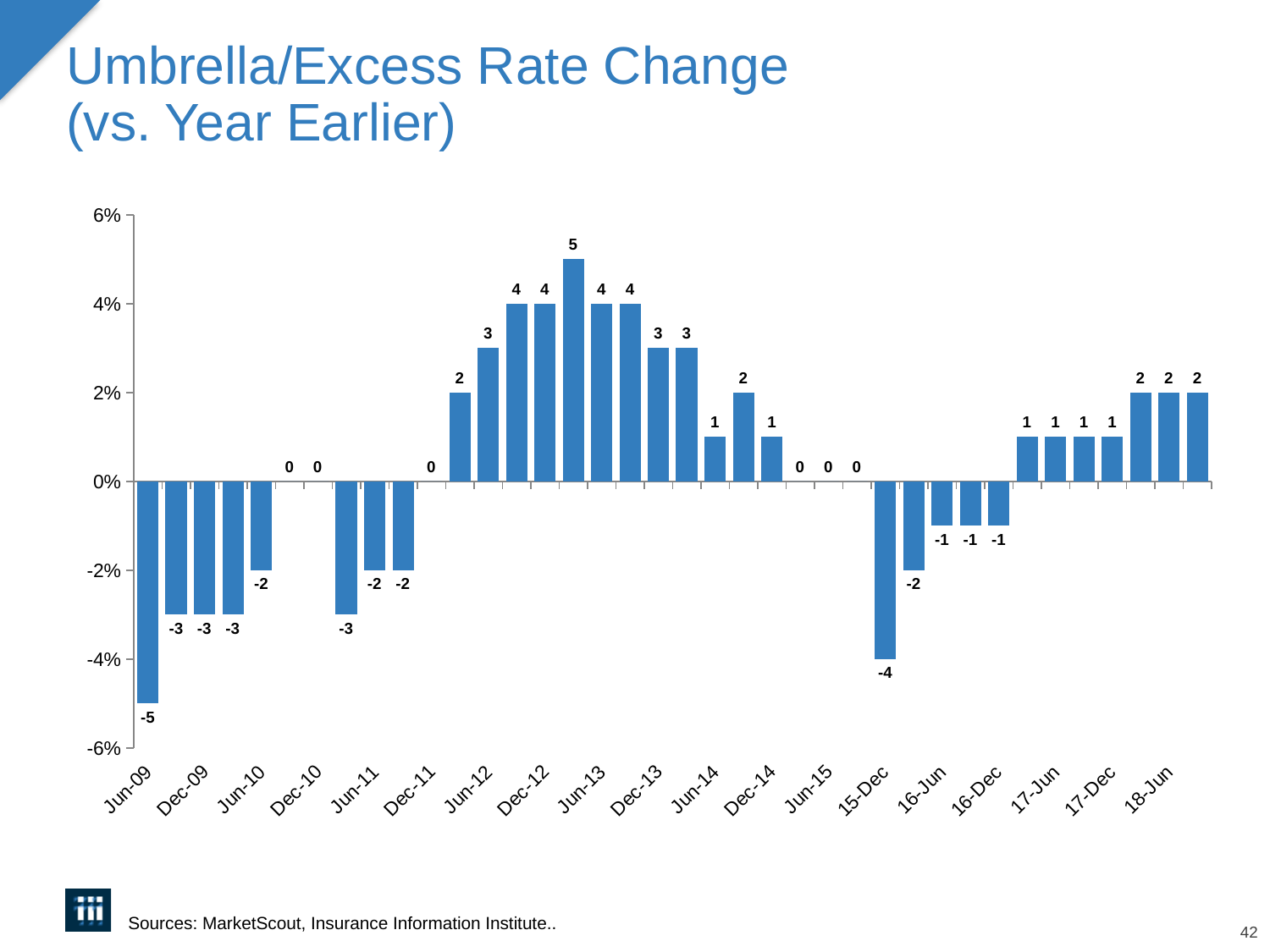
What is the title of the chart? Umbrella/Excess Rate Change (vs. Year Earlier) What kind of chart is shown on the slide? bar chart What is the value for Dec-11? 0 What is the value for 15-Dec? -4 What is the value for Jun-09? -5 How many period labels are shown on the x axis? 19 What is the highest value shown on the chart? 5 Which is larger, the value for Dec-09 or the value for Jun-10? Jun-10 Do the values rise or fall from 15-Dec to 18-Jun? rise What is the difference between the values for Dec-12 and Jun-12? 1 What is the value for 18-Jun? 2 Which labeled period has the lowest value? Jun-09